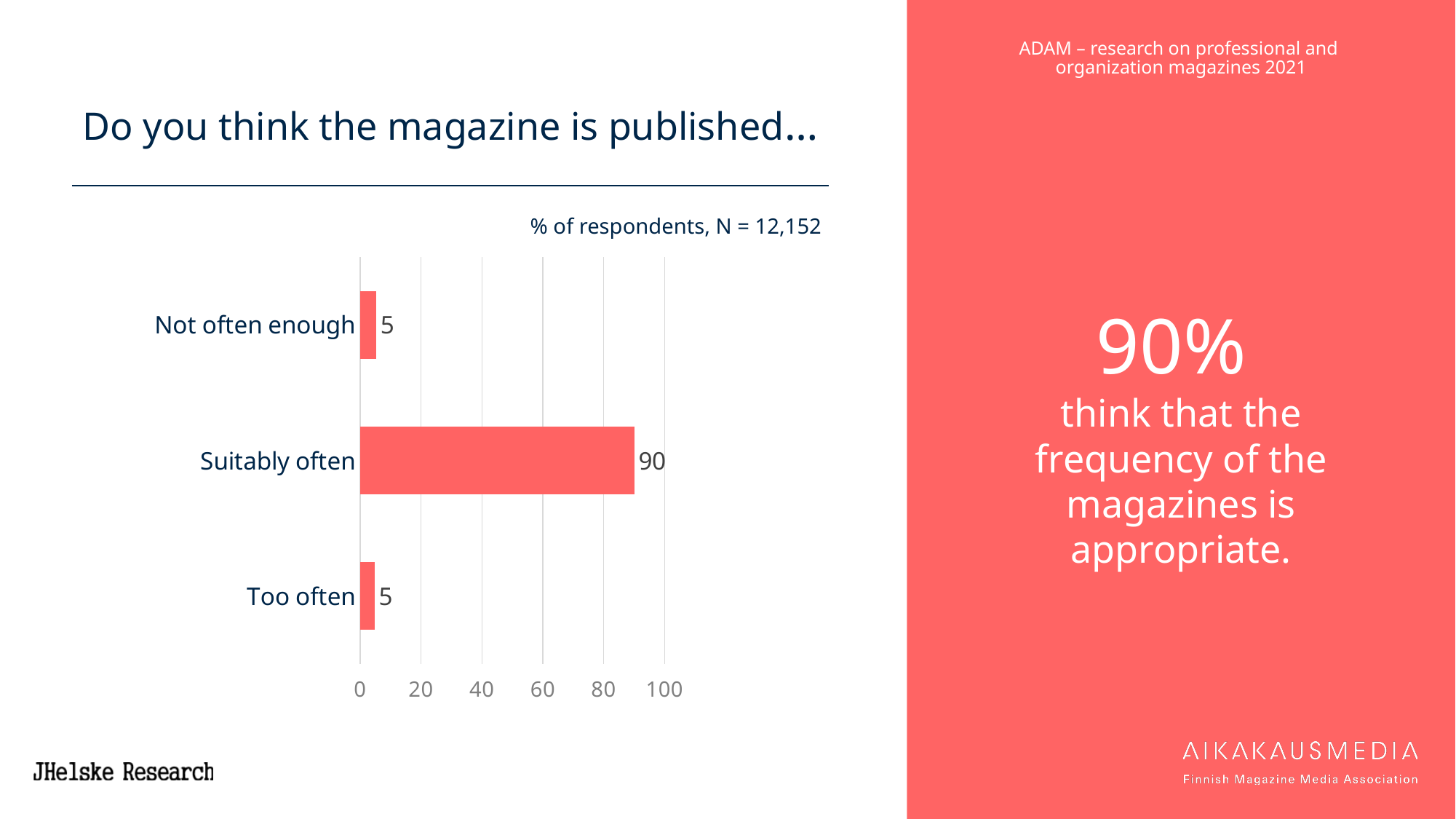
How many response categories are shown in the chart? 3 Which response category has the highest value? Suitably often Is the value for 'Not often enough' greater or less than 20? less What is the number of respondents (N) stated above the chart? 12,152 What kind of chart is shown on the slide? Bar chart What is the difference between the values for 'Suitably often' and 'Too often'? 85 What percentage of respondents think the magazine is published suitably often? 90 Is the value for 'Suitably often' greater or less than 80? greater Which is larger, the value for 'Suitably often' or the value for 'Not often enough'? Suitably often What percentage of respondents think the magazine is published too often? 5 What percentage of respondents think the magazine is published not often enough? 5 What is the total of the three values shown in the chart? 100